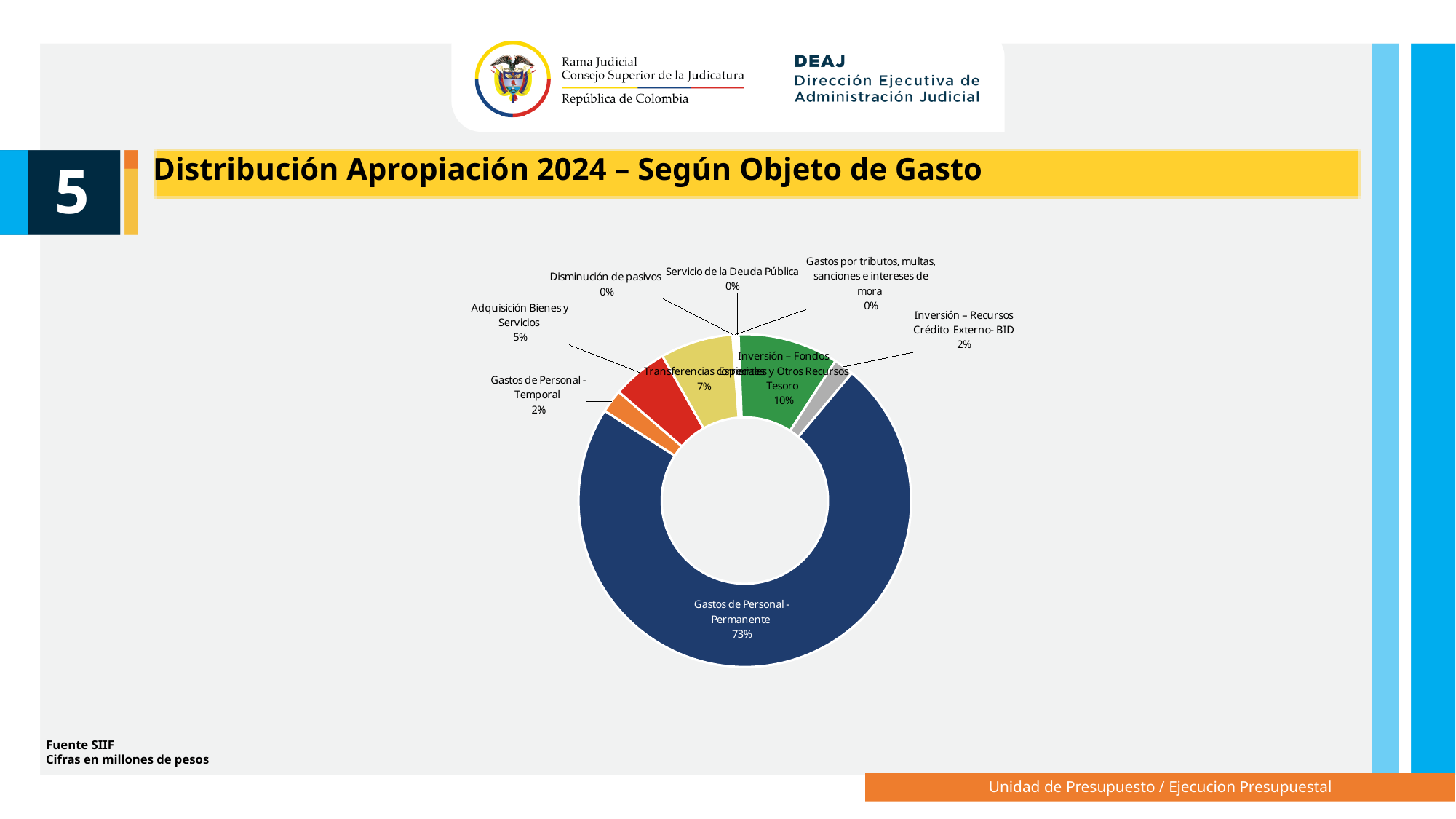
What kind of chart is shown on the slide? Doughnut (pie) chart What is the value shown for Gastos de Personal - Temporal? 2% What is the value shown for Inversión – Fondos Especiales y Otros Recursos Tesoro? 10% Which is larger, the share for Transferencias Corrientes or the share for Adquisición Bienes y Servicios? Transferencias Corrientes How many categories are labelled on the chart? 9 What is the value shown for Transferencias Corrientes? 7% What is the difference between the shares of Gastos de Personal - Permanente and Inversión – Fondos Especiales y Otros Recursos Tesoro? 63 percentage points What is the value shown for Adquisición Bienes y Servicios? 5% What is the title of the slide containing the chart? Distribución Apropiación 2024 – Según Objeto de Gasto What is the value shown for Inversión – Recursos Crédito Externo- BID? 2% What share of the chart does Gastos de Personal - Permanente represent? 73% Which category has the largest share of the chart? Gastos de Personal - Permanente